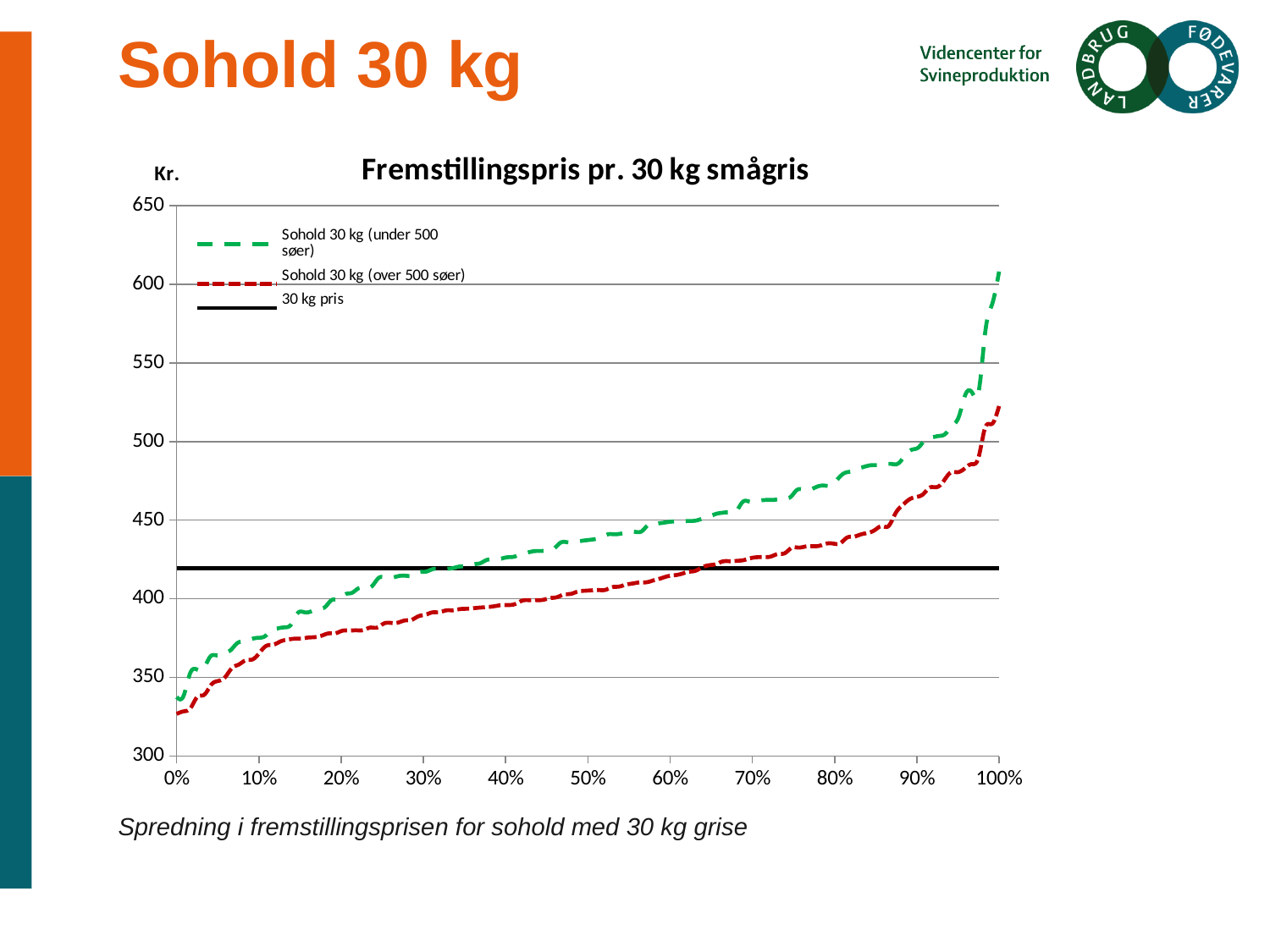
What is the title of the chart? Fremstillingspris pr. 30 kg smågris At 100%, which series has the higher value: 'Sohold 30 kg (under 500 søer)' or 'Sohold 30 kg (over 500 søer)'? Sohold 30 kg (under 500 søer) Is the value of the '30 kg pris' line greater or less than 400? greater Is the value for 'Sohold 30 kg (under 500 søer)' at 100% greater or less than 550? greater Does the 'Sohold 30 kg (under 500 søer)' line rise or fall along the x axis? Rise Is the value for 'Sohold 30 kg (over 500 søer)' at 0% greater or less than 350? less Does the 'Sohold 30 kg (over 500 søer)' line rise or fall along the x axis? Rise Which series is drawn as a solid black line? 30 kg pris How many series does the legend list? 3 At 50%, which series has the higher value: 'Sohold 30 kg (under 500 søer)' or 'Sohold 30 kg (over 500 søer)'? Sohold 30 kg (under 500 søer) What kind of chart is shown on the slide? Line chart